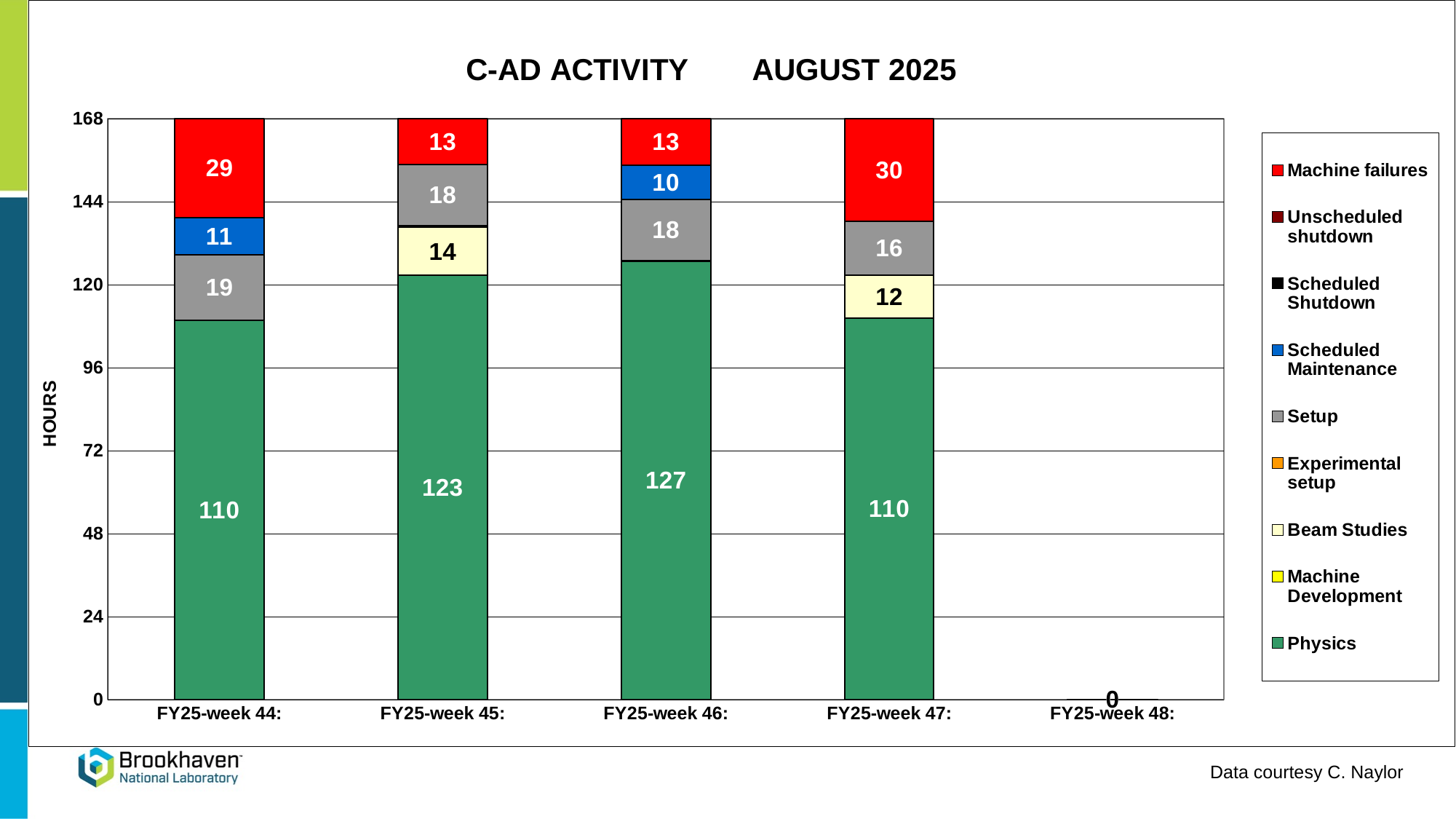
Which week has the larger Setup value, FY25-week 45 or FY25-week 47? FY25-week 45 How many weeks are shown on the x axis? 5 What is the total of the stacked bar for FY25-week 45? 168 How many series does the legend list? 9 How many hours of Physics are shown for FY25-week 46? 127 What is the Scheduled Maintenance value for FY25-week 46? 10 What is the difference between the Machine failures values for FY25-week 47 and FY25-week 45? 17 What is the Beam Studies value for FY25-week 45? 14 What kind of chart is shown on the slide? Stacked bar chart Which week has the highest Physics hours? FY25-week 46 What is the Machine failures value for FY25-week 47? 30 What is the Setup value for FY25-week 44? 19